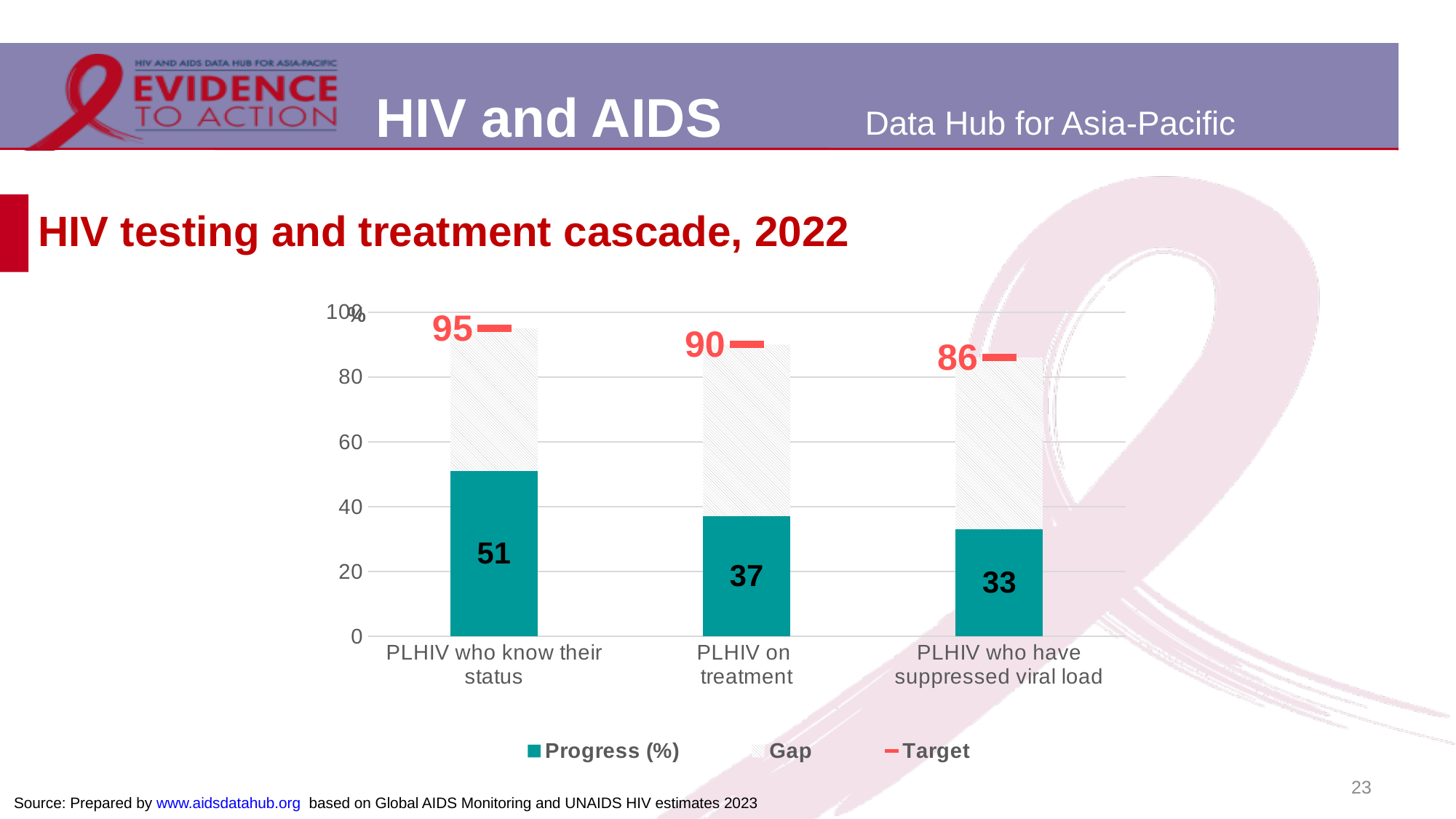
What is the difference between the Target and the Progress (%) for PLHIV who know their status? 44 What is the Target value for PLHIV who have suppressed viral load? 86 Which category has the lowest Progress (%) value? PLHIV who have suppressed viral load Which category has the highest Progress (%) value? PLHIV who know their status Do the Progress (%) values rise or fall from left to right along the x axis? fall Which is larger, the Progress (%) for PLHIV on treatment or for PLHIV who have suppressed viral load? PLHIV on treatment What is the Progress (%) value for PLHIV on treatment? 37 What is the Progress (%) value for PLHIV who have suppressed viral load? 33 What is the Progress (%) value for PLHIV who know their status? 51 How many series does the legend list? 3 What is the Target value for PLHIV on treatment? 90 How many categories are shown on the x axis? 3